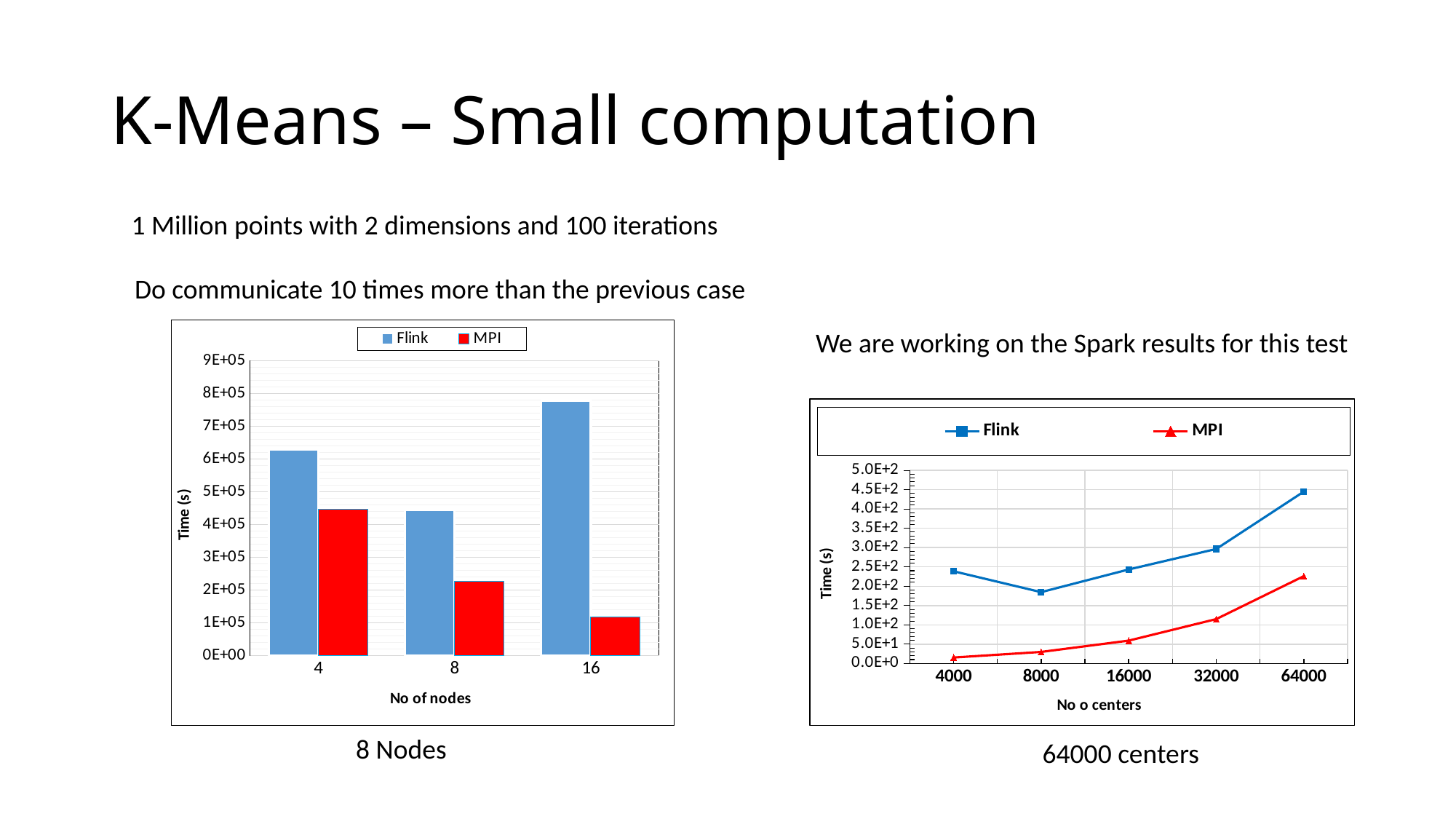
In the left chart, how many series does the legend list? 2 In the right chart, how many values of 'No o centers' are plotted on the x axis? 5 In the left chart, is the Flink value at 16 nodes greater or less than 7E+05? greater In the left chart, which is larger at 4 nodes, Flink or MPI? Flink In the left chart, at which number of nodes is the MPI bar lowest? 16 What kind of chart is the left chart (x axis 'No of nodes')? bar chart In the right chart, does the MPI line rise or fall as the number of centers increases? rises In the left chart, is the MPI value at 8 nodes greater or less than 3E+05? less What kind of chart is the right chart (x axis 'No o centers')? line chart In the left chart, at which number of nodes is the Flink bar highest? 16 In the left chart, how many node counts are shown on the x axis? 3 In the right chart, is the Flink value at 64000 centers greater or less than 4.0E+2? greater